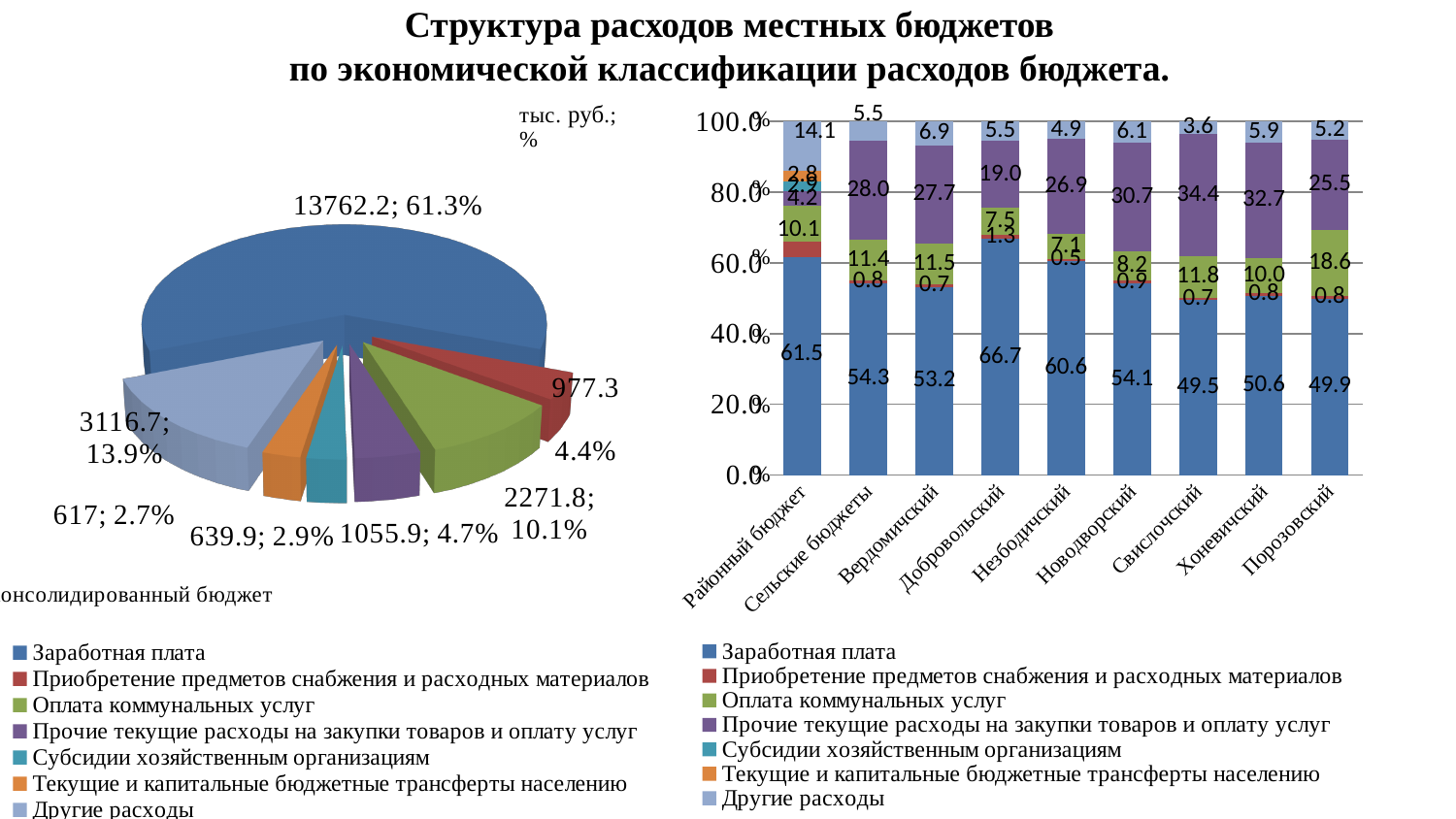
On the pie chart on the left, how many slices are there? 7 On the pie chart on the left, what is the value of the slice with a 10.1% share? 2271.8 On the stacked bar chart on the right, which category has the lowest value for Другие расходы? Свислочский On the stacked bar chart on the right, what is the value of Заработная плата for Добровольский? 66.7 On the stacked bar chart on the right, which category has the highest value for Заработная плата? Добровольский On the stacked bar chart on the right, how many series does the legend list? 7 On the stacked bar chart on the right, how many categories are shown on the x axis? 9 On the stacked bar chart on the right, what is the value of Другие расходы for Районный бюджет? 14.1 What kind of chart is the chart on the right? Stacked bar chart On the stacked bar chart on the right, what is the difference between the Заработная плата values for Районный бюджет (61.5) and Сельские бюджеты (54.3)? 7.2 On the pie chart on the left, what share does the slice labelled 3116.7 have? 13.9% On the pie chart on the left, what value and share are shown for the largest slice (Заработная плата)? 13762.2; 61.3%